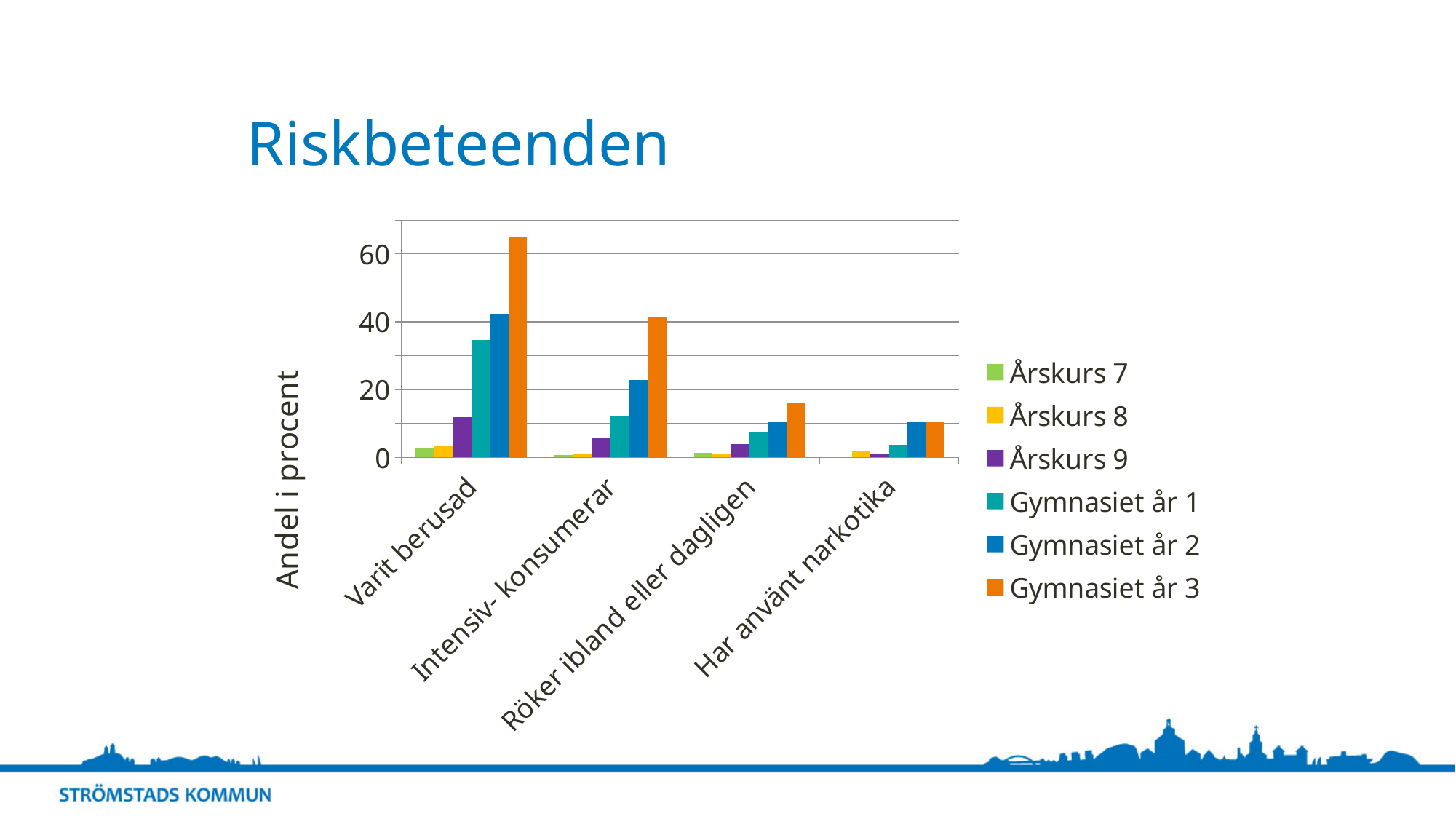
Is the Gymnasiet år 1 value for Varit berusad greater or less than 40? less How many categories are shown on the x axis of the chart? 4 What kind of chart is shown on the slide? Bar chart What is the title of the chart on the slide? Riskbeteenden How many series does the legend list? 6 Is the Gymnasiet år 2 value for Intensiv- konsumerar greater or less than 20? greater For which category is the Gymnasiet år 3 value highest? Varit berusad What is the label on the vertical axis of the chart? Andel i procent Is the Gymnasiet år 3 value for Varit berusad greater or less than 60? greater For Varit berusad, which is larger: the Gymnasiet år 2 value or the Gymnasiet år 3 value? Gymnasiet år 3 Which series has the highest value for Varit berusad? Gymnasiet år 3